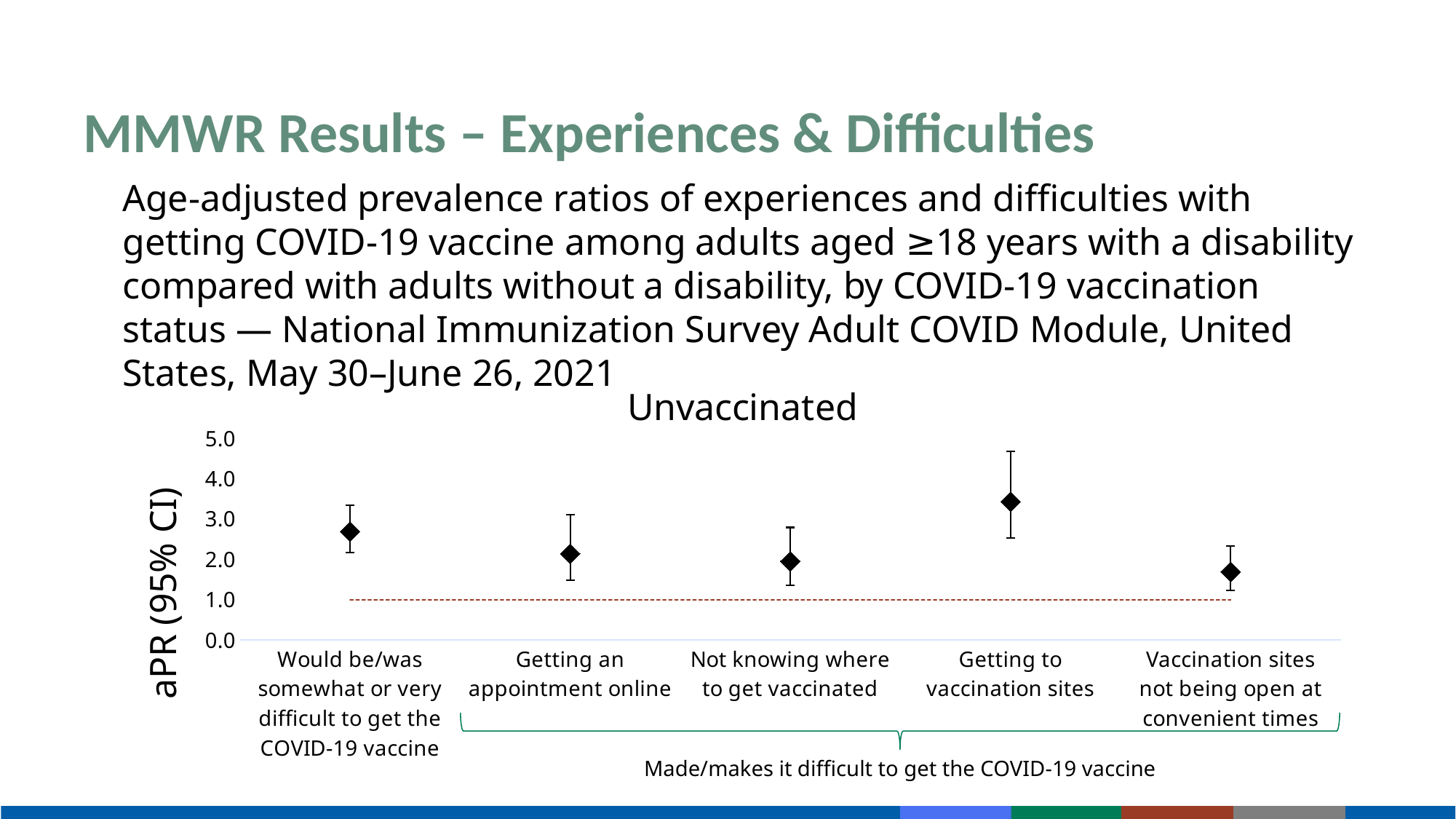
What is the title of the chart? Unvaccinated Which has a higher aPR value: Would be/was somewhat or very difficult to get the COVID-19 vaccine, or Getting an appointment online? Would be/was somewhat or very difficult to get the COVID-19 vaccine Is the aPR value for Getting an appointment online greater or less than 1.0? greater Which category has the lowest aPR value? Vaccination sites not being open at convenient times What is the label on the vertical axis of the chart? aPR (95% CI) Is the aPR value for Vaccination sites not being open at convenient times greater or less than 2.0? less What is the maximum value shown on the vertical axis of the chart? 5.0 Is the aPR value for Getting to vaccination sites greater or less than 3.0? greater How many categories are plotted on the chart? 5 Which category has the highest aPR value? Getting to vaccination sites